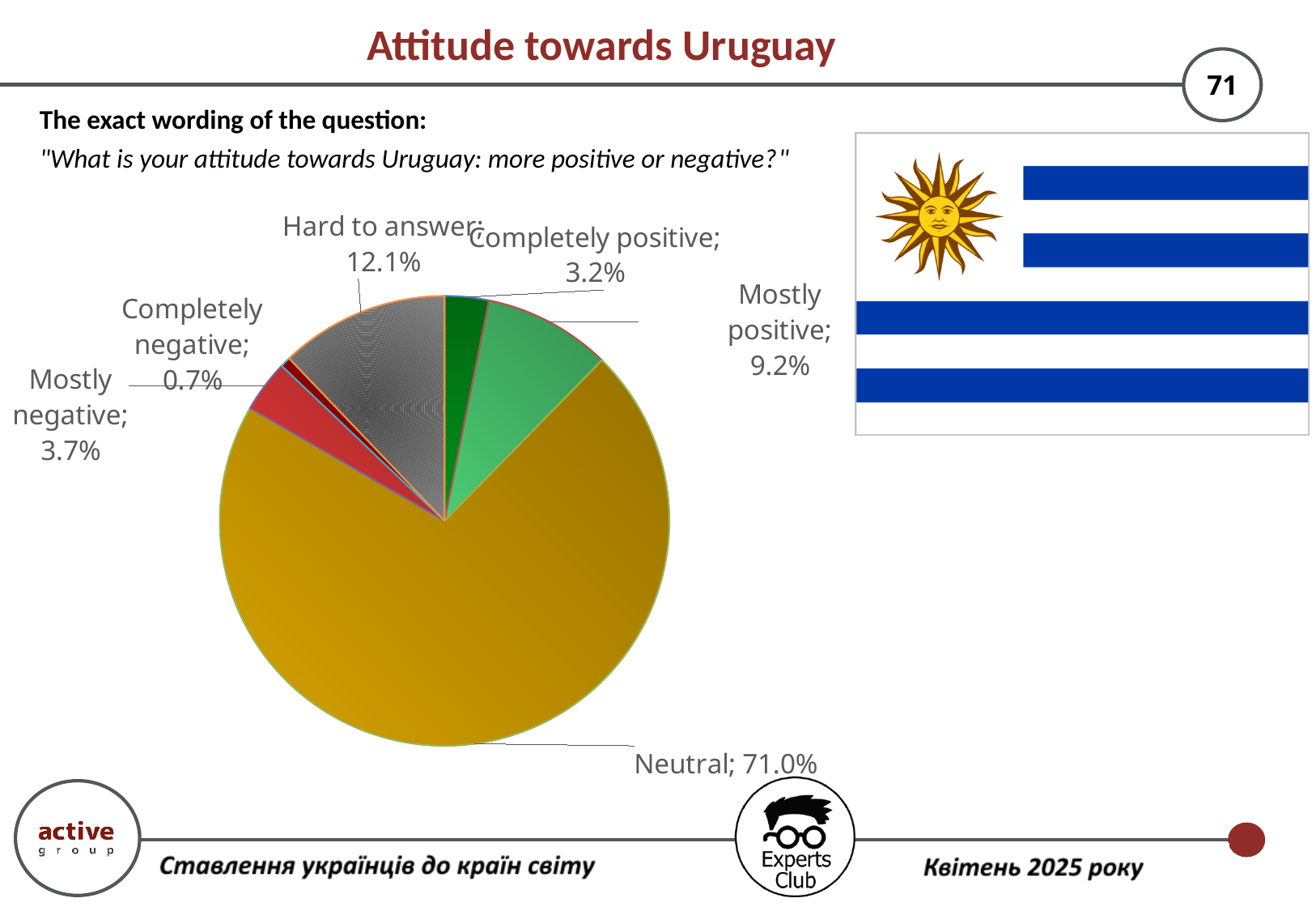
Which is larger: "Completely positive" or "Mostly negative"? Mostly negative Which category has the largest slice of the pie? Neutral What is the title of the slide containing the chart? Attitude towards Uruguay What kind of chart is shown on the slide? Pie chart How many categories are shown in the pie chart? 6 What is the combined share of "Completely positive" and "Mostly positive"? 12.4% What is the value for "Mostly positive"? 9.2% What is the difference between "Mostly positive" and "Mostly negative"? 5.5% What percentage of respondents chose "Hard to answer"? 12.1% What share of respondents answered "Neutral"? 71.0% Which category has the smallest slice of the pie? Completely negative What is the value for "Completely negative"? 0.7%